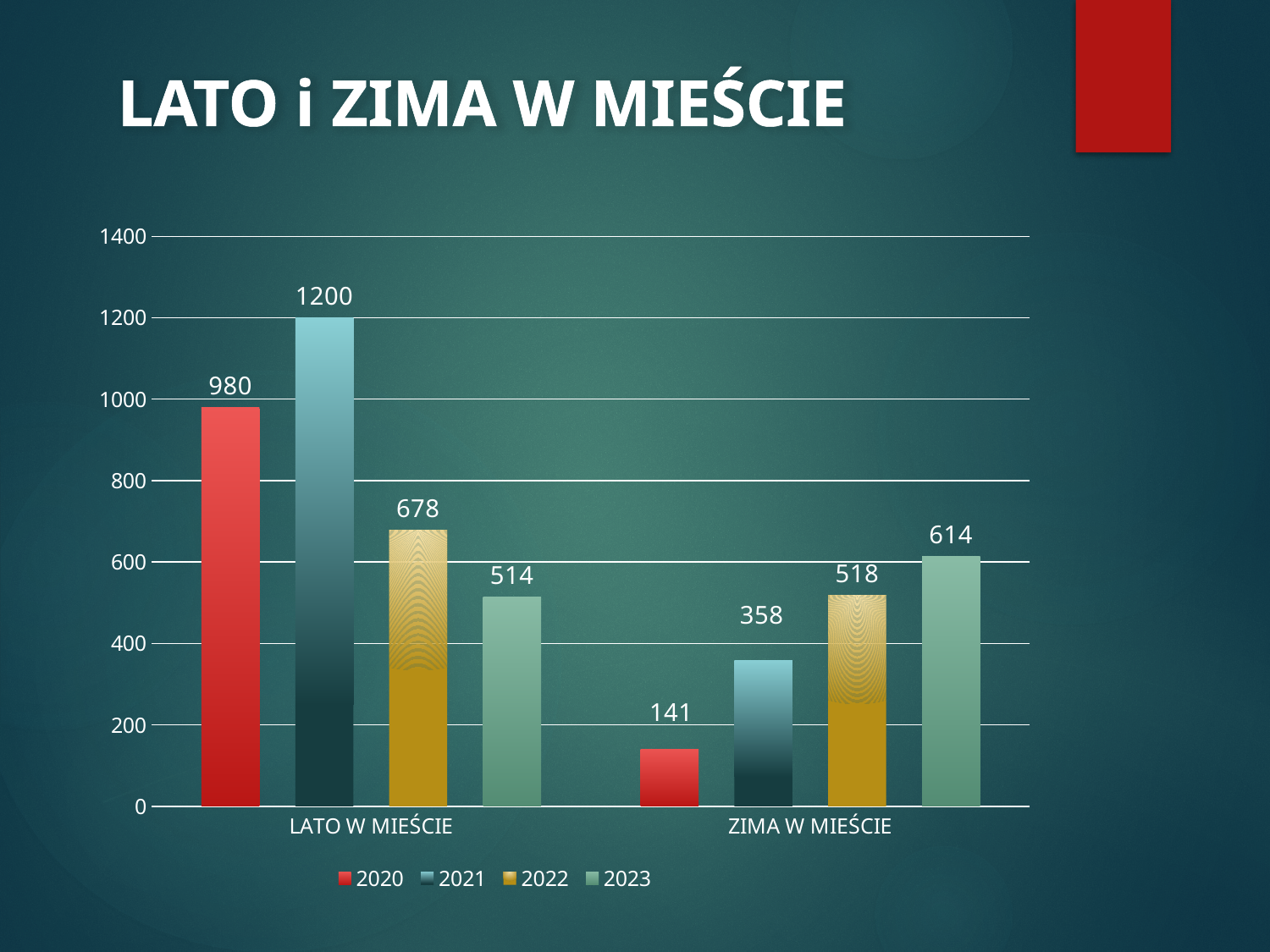
What is the title of the slide? LATO i ZIMA W MIEŚCIE What kind of chart is shown on the slide? bar chart What is the value for 2020 in the ZIMA W MIEŚCIE category? 141 Which is larger: the 2022 value for LATO W MIEŚCIE or the 2022 value for ZIMA W MIEŚCIE? LATO W MIEŚCIE What is the value for 2023 in the ZIMA W MIEŚCIE category? 614 Which year has the lowest value in the ZIMA W MIEŚCIE category? 2020 What is the value for 2021 in the LATO W MIEŚCIE category? 1200 What is the difference between the 2020 values for LATO W MIEŚCIE and ZIMA W MIEŚCIE? 839 How many series does the legend list? 4 How many categories are shown on the x axis? 2 Which year has the highest value in the LATO W MIEŚCIE category? 2021 Is the value for 2021 in ZIMA W MIEŚCIE greater or less than 400? less